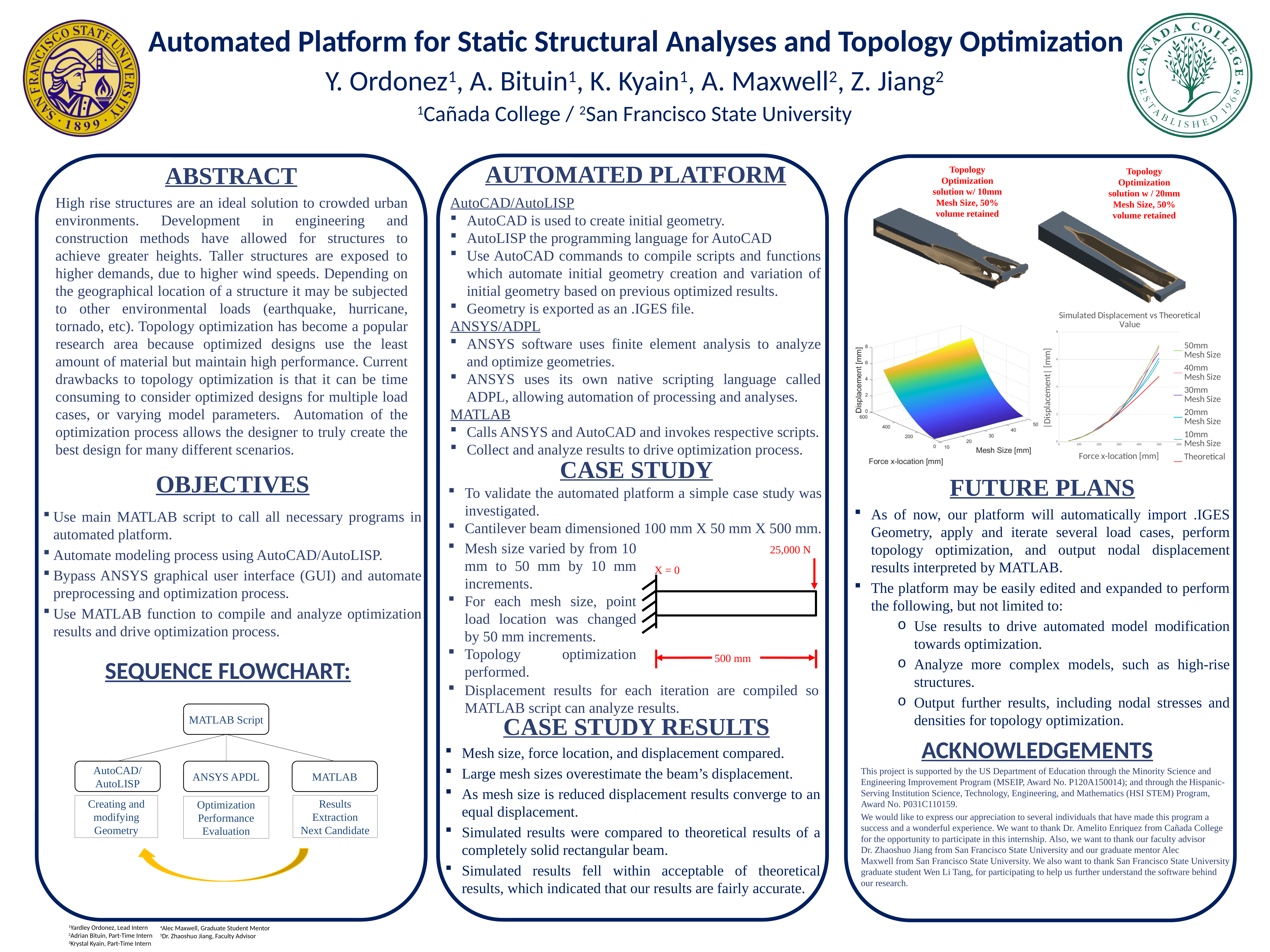
In the 'Simulated Displacement vs Theoretical Value' chart, do the displacement values rise or fall as force x-location increases? rise What kind of chart is the 3D plot of Displacement against Force x-location and Mesh Size? surface plot In the 'Simulated Displacement vs Theoretical Value' chart, how many series does the legend list? 6 In the 3D surface plot on the right side of the poster, does displacement rise or fall as force x-location increases? rise In the 'Simulated Displacement vs Theoretical Value' chart, at the largest force x-location, is the displacement for the 50mm Mesh Size series larger or smaller than the Theoretical series? larger In the 'Simulated Displacement vs Theoretical Value' chart, which series has the lowest displacement at the largest force x-location? Theoretical What kind of chart is 'Simulated Displacement vs Theoretical Value'? line chart What is the x-axis label of the 'Simulated Displacement vs Theoretical Value' chart? Force x-location [mm] In the 'Simulated Displacement vs Theoretical Value' chart, which series has the highest displacement at the largest force x-location? 50mm Mesh Size In the 'Simulated Displacement vs Theoretical Value' chart, is the 50mm Mesh Size displacement at the largest force x-location greater or less than 6? greater In the 'Simulated Displacement vs Theoretical Value' chart, is the Theoretical displacement at the largest force x-location greater or less than 6? less What is the title of the line chart on the right side of the poster? Simulated Displacement vs Theoretical Value